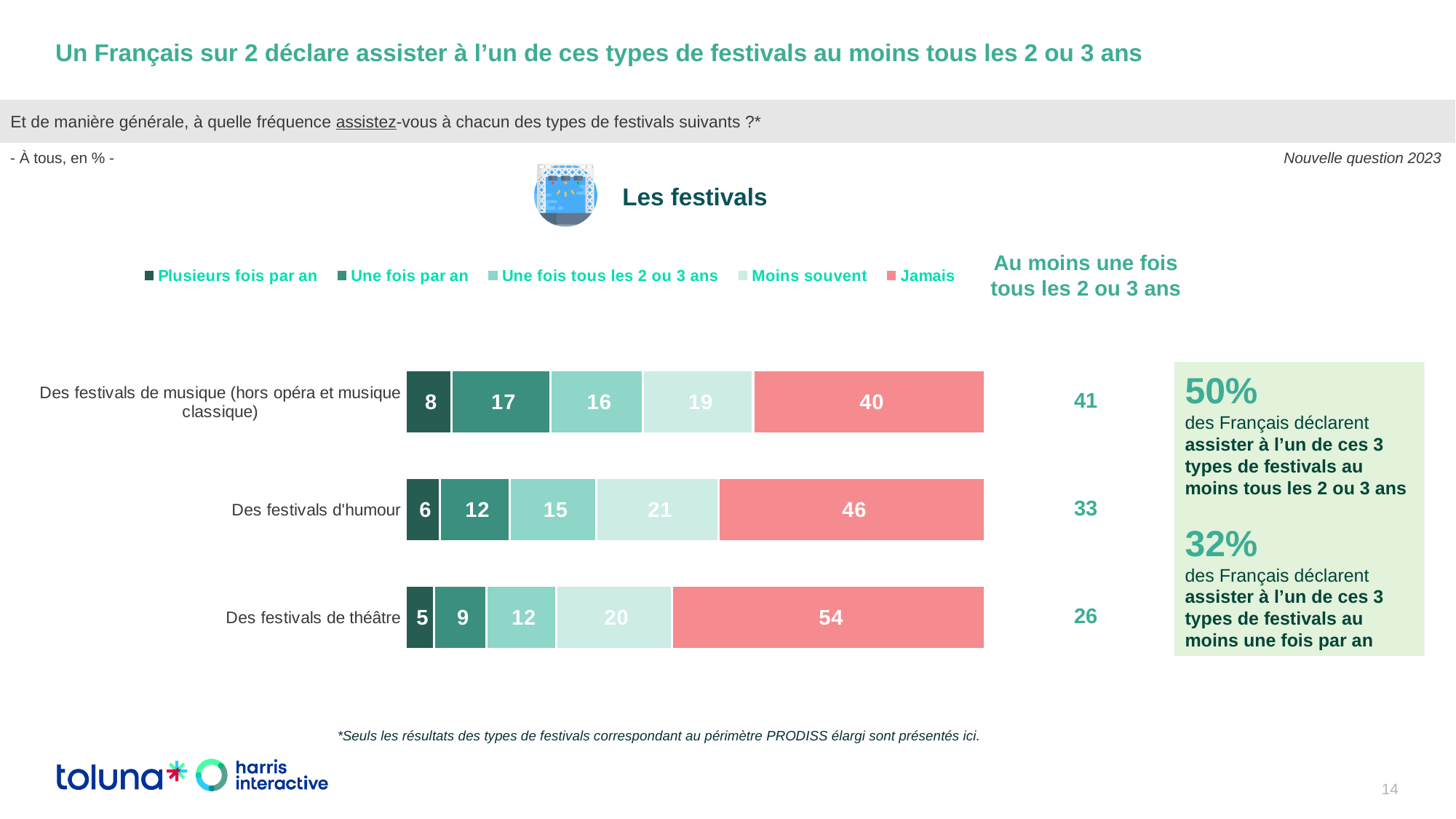
Which type of festival has the highest 'Jamais' value? Des festivals de théâtre Which is larger: the 'Une fois tous les 2 ou 3 ans' value for 'Des festivals de musique' or for 'Des festivals d'humour'? Des festivals de musique What kind of chart is shown on the slide? Stacked bar chart What is the value for 'Moins souvent' for 'Des festivals de théâtre'? 20 How many series does the legend list? 5 What is the total of the stacked bar for 'Des festivals d'humour'? 100 What is the difference between the 'Jamais' values for 'Des festivals de théâtre' and 'Des festivals de musique'? 14 How many types of festivals are shown in the chart? 3 What percentage of respondents say they never attend music festivals (hors opéra et musique classique)? 40 What is the 'Au moins une fois tous les 2 ou 3 ans' value shown for 'Des festivals de théâtre'? 26 What is the value for 'Une fois par an' for 'Des festivals d'humour'? 12 Which type of festival has the lowest 'Plusieurs fois par an' value? Des festivals de théâtre